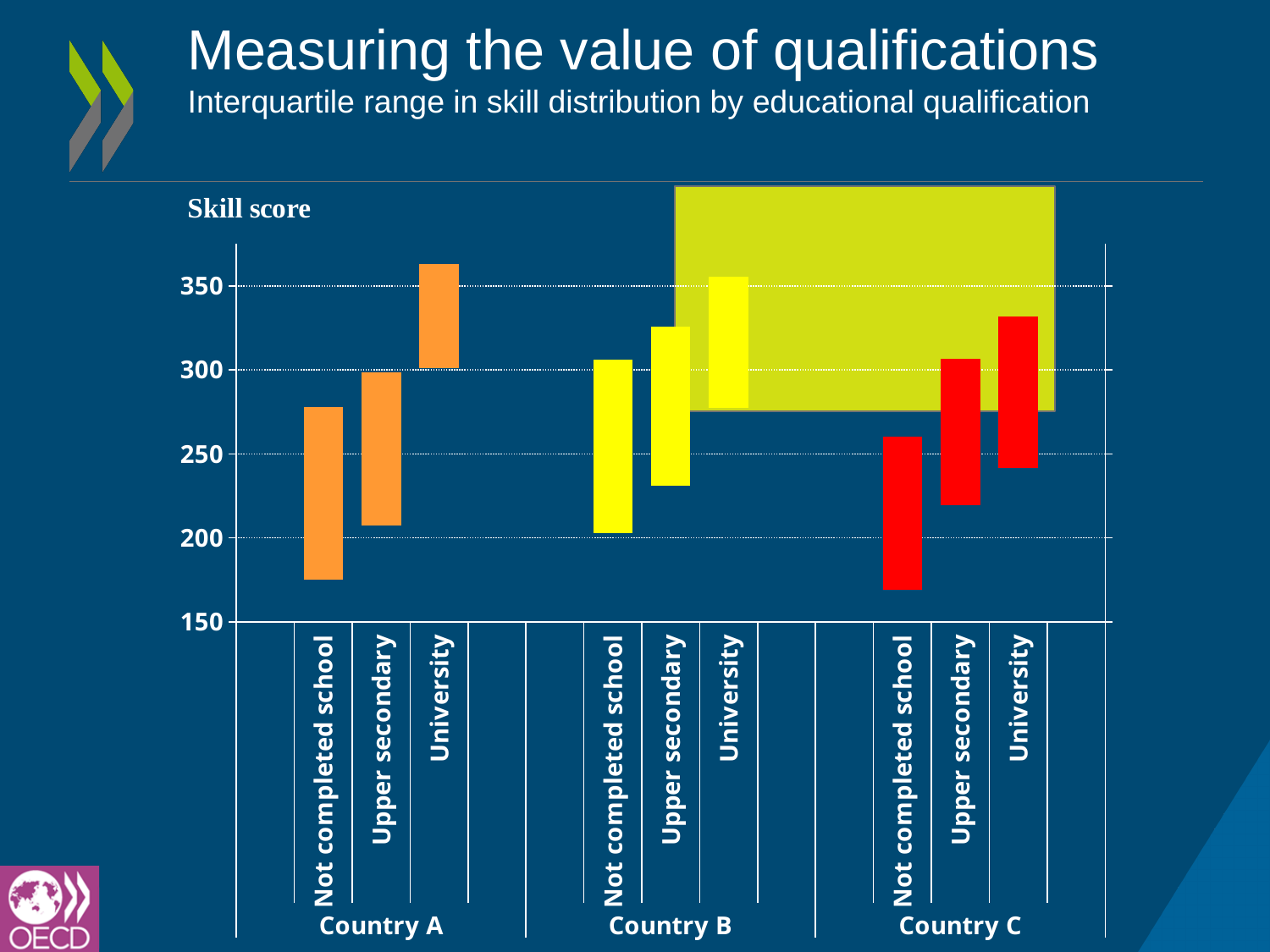
Is the top of the University range for Country A greater or less than 350? greater Is the bottom of the Upper secondary range for Country C greater or less than 200? greater How many bars (interquartile ranges) are plotted in the chart in total? 9 Is the bottom of the Not completed school range for Country C greater or less than 200? less What kind of chart is shown on the slide? bar chart What is the label of the vertical axis of the chart? Skill score How many educational qualification levels are shown for each country? 3 How many countries are shown along the x axis of the chart? 3 Which reaches a higher skill score at the top of its range: University in Country A or University in Country C? University in Country A What colour are the bars for Country C? red